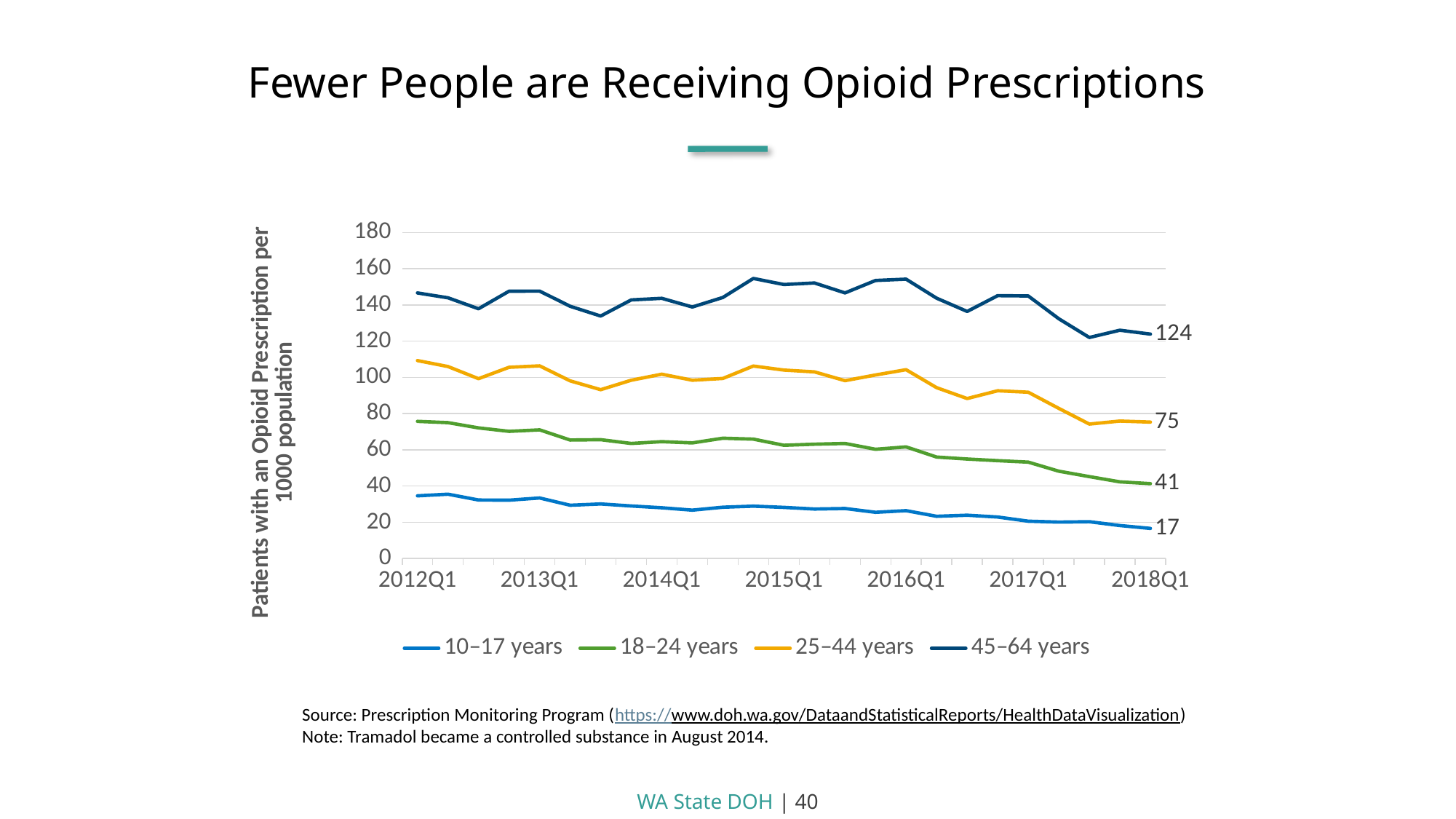
Is the value for the 45–64 years series at 2012Q1 greater or less than 140? greater Which age group has the highest value at 2018Q1? 45–64 years What is the value for the 10–17 years series at 2018Q1? 17 What kind of chart is shown on the slide? Line chart Which age group has the lowest value at 2018Q1? 10–17 years What is the value for the 25–44 years series at 2018Q1? 75 What is the difference between the 45–64 years and 25–44 years values at 2018Q1? 49 How many series does the legend list? 4 Do the values for the 25–44 years series rise or fall from 2012Q1 to 2018Q1? Fall What is the value for the 18–24 years series at 2018Q1? 41 What is the value for the 45–64 years series at 2018Q1? 124 At 2018Q1, which is larger: the 18–24 years value or the 10–17 years value? 18–24 years